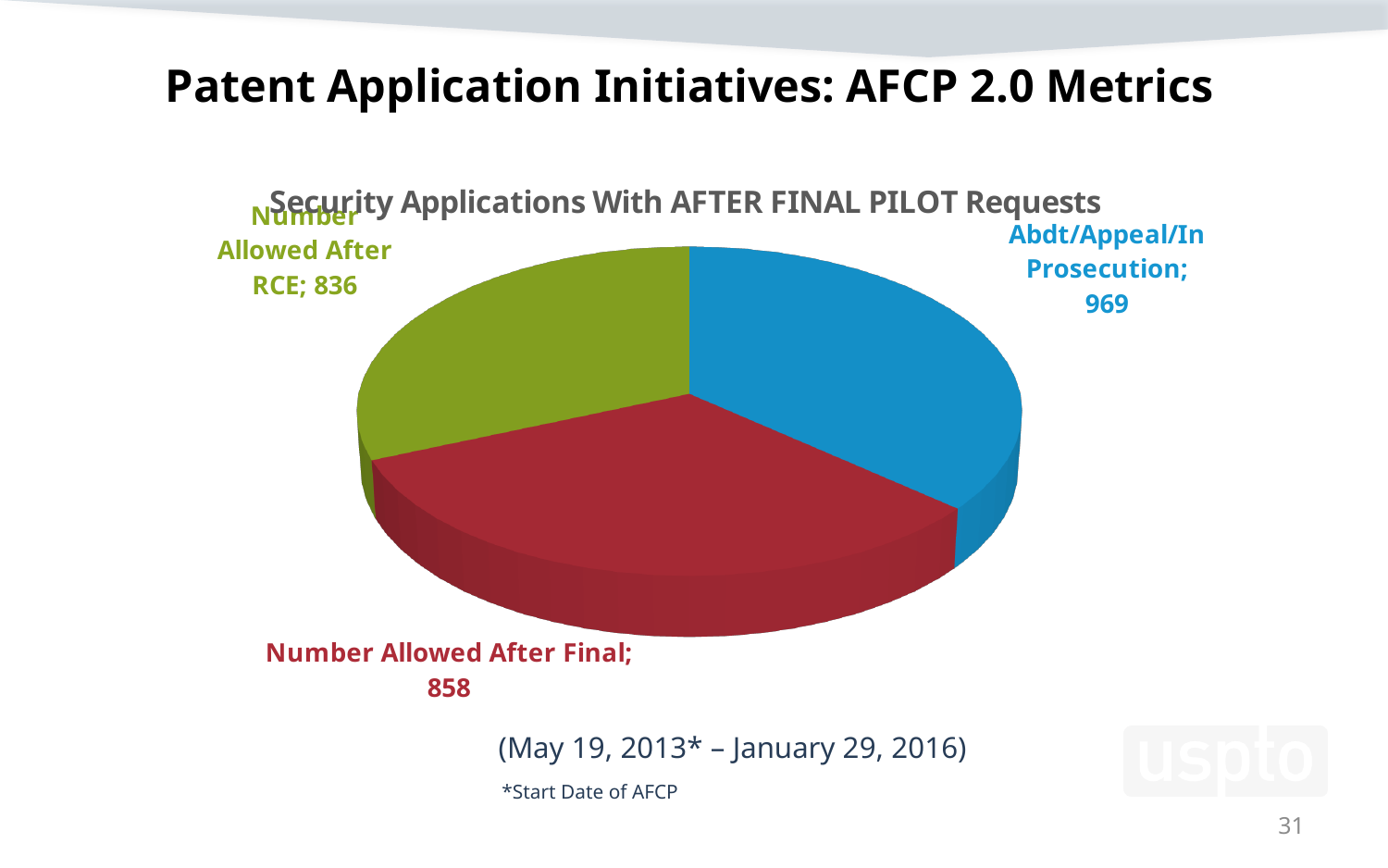
How many slices does the pie chart have? 3 Which category has the lowest value? Number Allowed After RCE What colour is the slice for Number Allowed After RCE? Green What is the title of the chart? Security Applications With AFTER FINAL PILOT Requests What kind of chart is shown on the slide? Pie chart What is the difference between Number Allowed After Final and Number Allowed After RCE? 22 What is the value for Abdt/Appeal/In Prosecution? 969 What is the value for Number Allowed After RCE? 836 Which is larger, Number Allowed After Final or Number Allowed After RCE? Number Allowed After Final Which category has the highest value? Abdt/Appeal/In Prosecution What is the value for Number Allowed After Final? 858 What is the difference between Abdt/Appeal/In Prosecution and Number Allowed After Final? 111